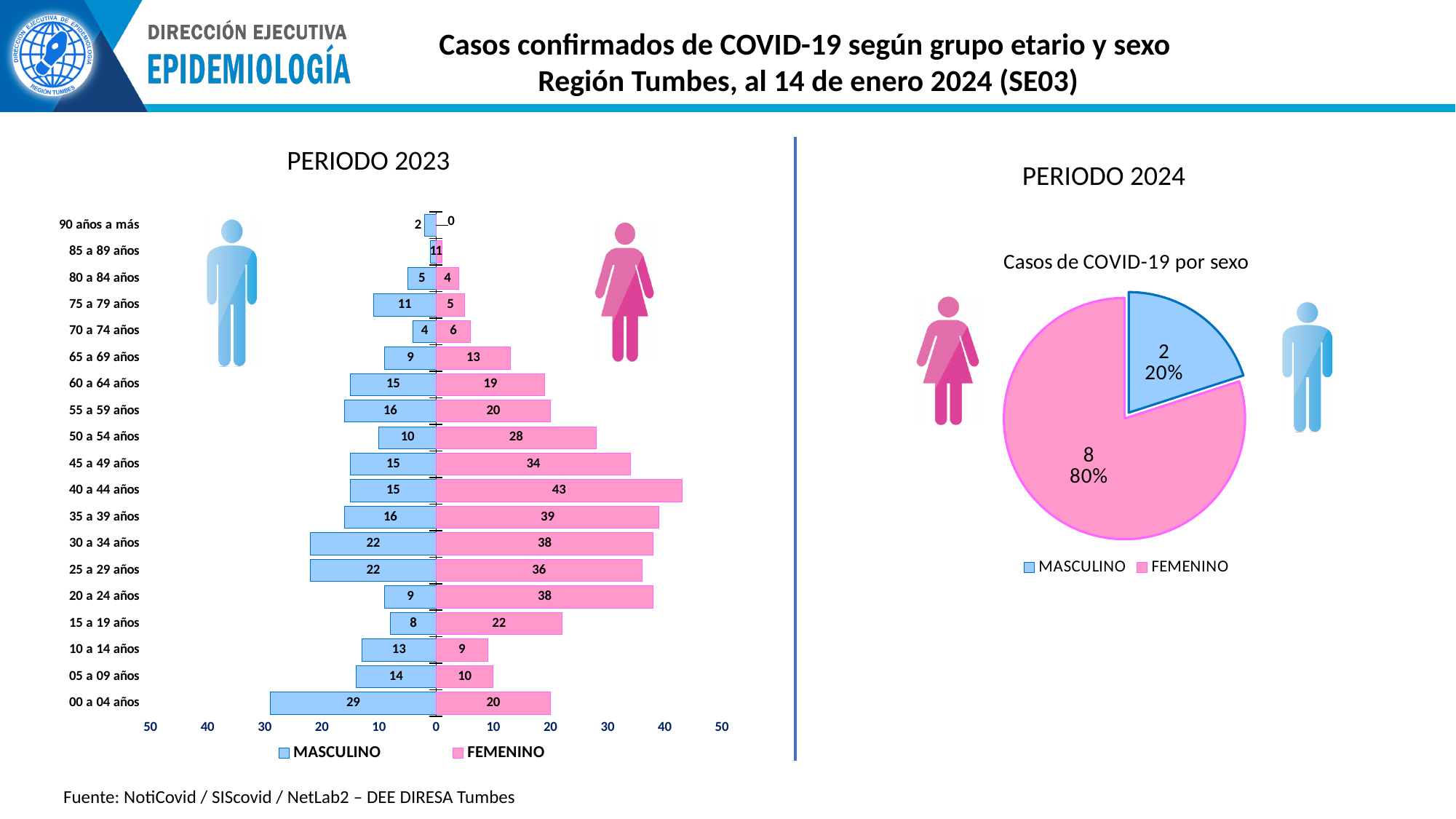
In the PERIODO 2023 chart, which age group has the highest FEMENINO value? 40 a 44 años In the PERIODO 2024 pie chart, what share of cases is FEMENINO? 80% In the PERIODO 2023 chart, how many age groups are shown? 19 In the PERIODO 2023 chart, what is the difference between the FEMENINO and MASCULINO values for the 20 a 24 años group? 29 In the PERIODO 2023 chart, which age group has the highest MASCULINO value? 00 a 04 años What type of chart is the PERIODO 2023 chart? Bar chart How many series does the legend of the PERIODO 2024 pie chart list? 2 In the PERIODO 2023 chart, how many MASCULINO cases are shown for the 00 a 04 años group? 29 In the PERIODO 2024 pie chart, how many MASCULINO cases are shown? 2 In the PERIODO 2023 chart, how many FEMENINO cases are shown for the 40 a 44 años group? 43 What is the title of the pie chart on the right side of the slide? Casos de COVID-19 por sexo In the PERIODO 2023 chart, which is larger for the 75 a 79 años group, MASCULINO or FEMENINO? MASCULINO